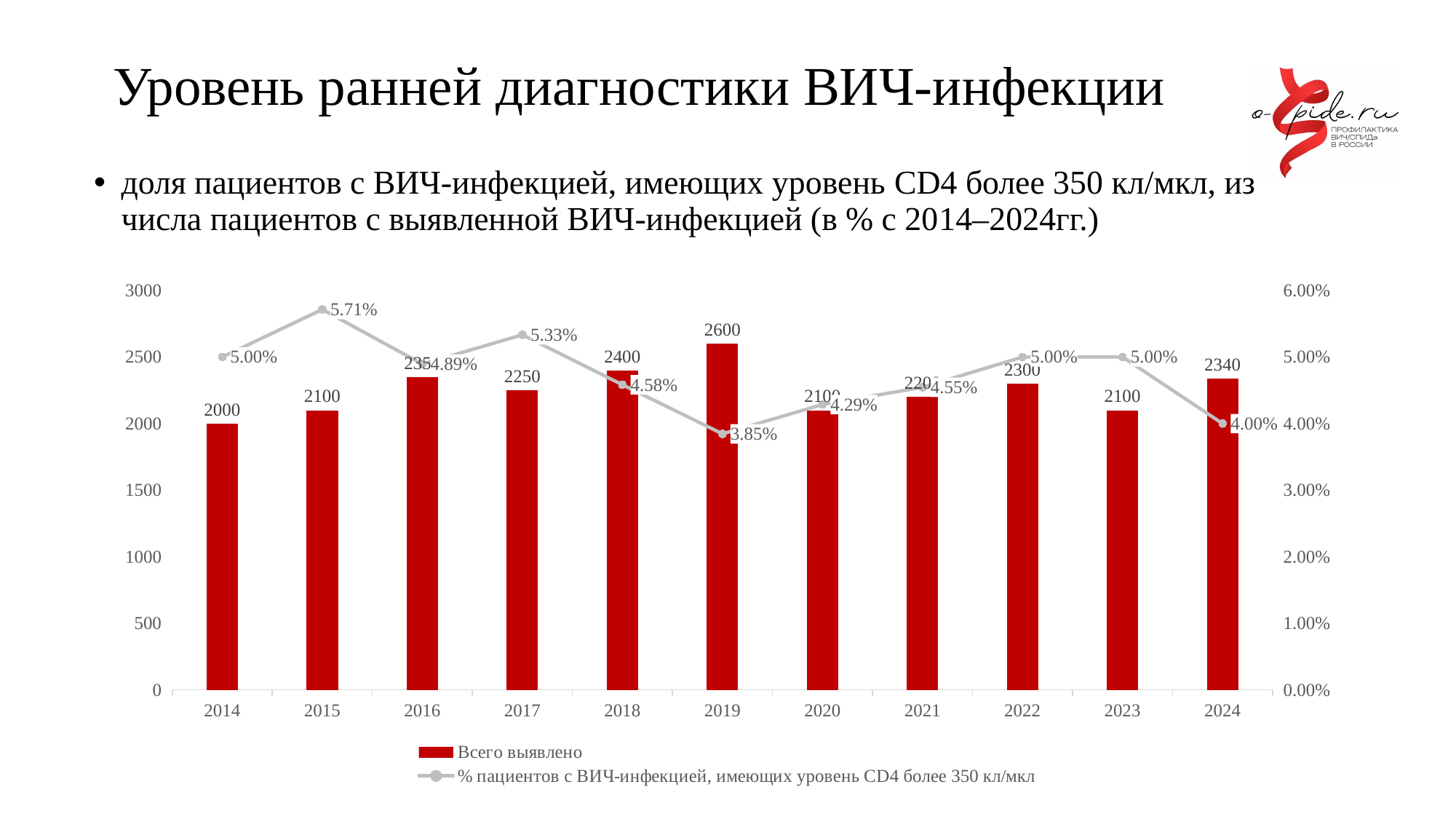
How many years are shown on the x axis of the chart? 11 What is the difference between the 'Всего выявлено' values for 2019 and 2014? 600 How many series does the legend list? 2 In which year is the percentage of patients with CD4 above 350 кл/мкл the lowest? 2019 What percentage of patients had a CD4 level above 350 кл/мкл in 2015? 5.71% What is the value of 'Всего выявлено' for 2024? 2340 What is the value of 'Всего выявлено' for 2019? 2600 Which year has the lowest value of 'Всего выявлено'? 2014 Which year has a larger 'Всего выявлено' value, 2018 or 2022? 2018 Is the 'Всего выявлено' value for 2023 greater or less than 2500? less What kind of chart is shown on the slide? Combined bar and line chart Which year has the highest value of 'Всего выявлено'? 2019